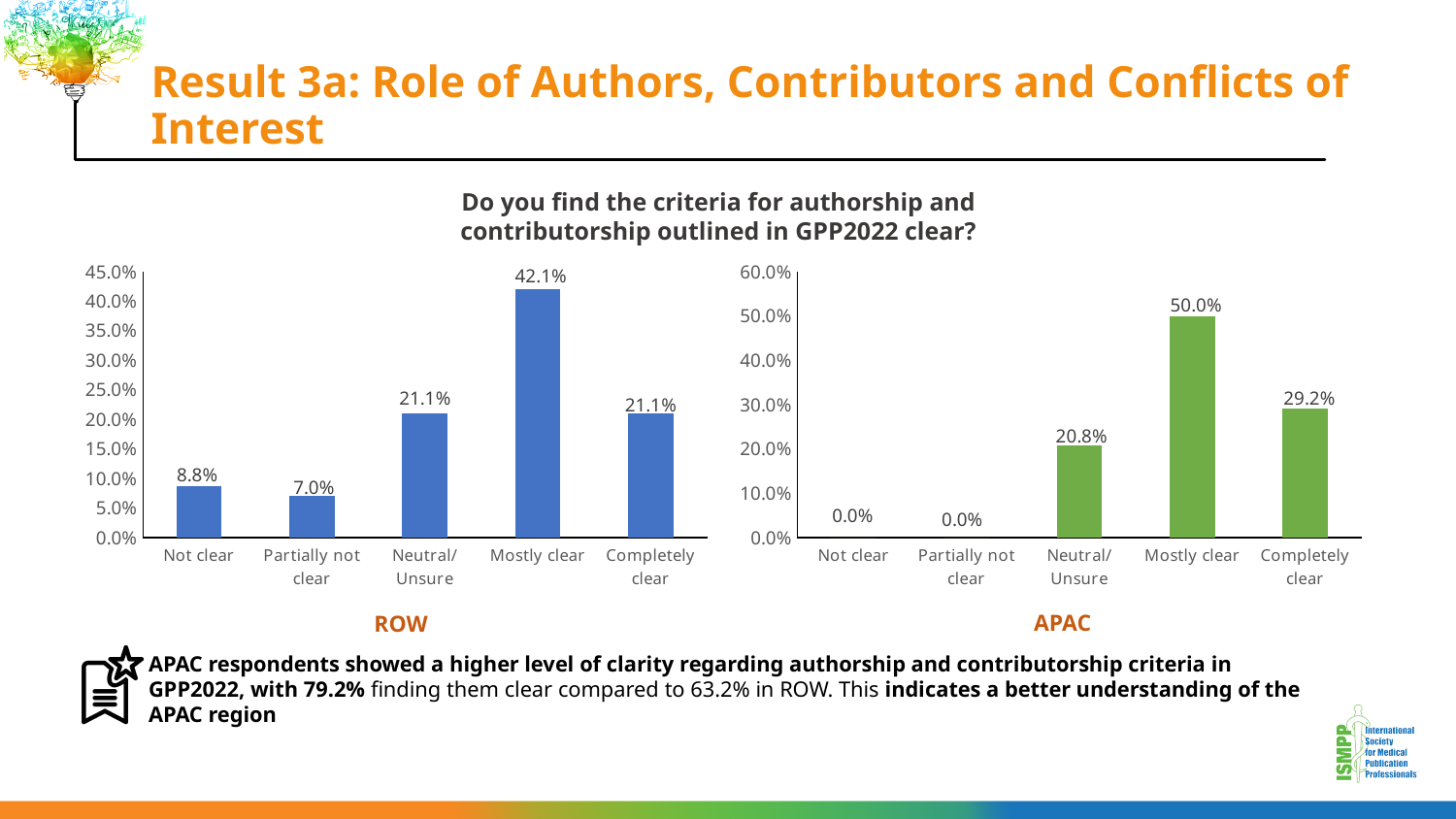
What colour are the bars in the APAC chart? Green In the APAC chart, what is the value for Completely clear? 29.2% In the ROW chart, what is the value for Mostly clear? 42.1% In the ROW chart, which category has the lowest value? Partially not clear In the ROW chart, which is larger: Not clear or Neutral/Unsure? Neutral/Unsure In the ROW chart, what is the value for Partially not clear? 7.0% In the ROW chart, what is the difference between Mostly clear and Completely clear? 21.0% In the APAC chart, which category has the highest value? Mostly clear How many categories are shown on the x axis of the APAC chart? 5 In the APAC chart, what is the value for Not clear? 0.0% What kind of chart is the ROW chart? Bar chart In the APAC chart, what is the difference between Mostly clear and Neutral/Unsure? 29.2%